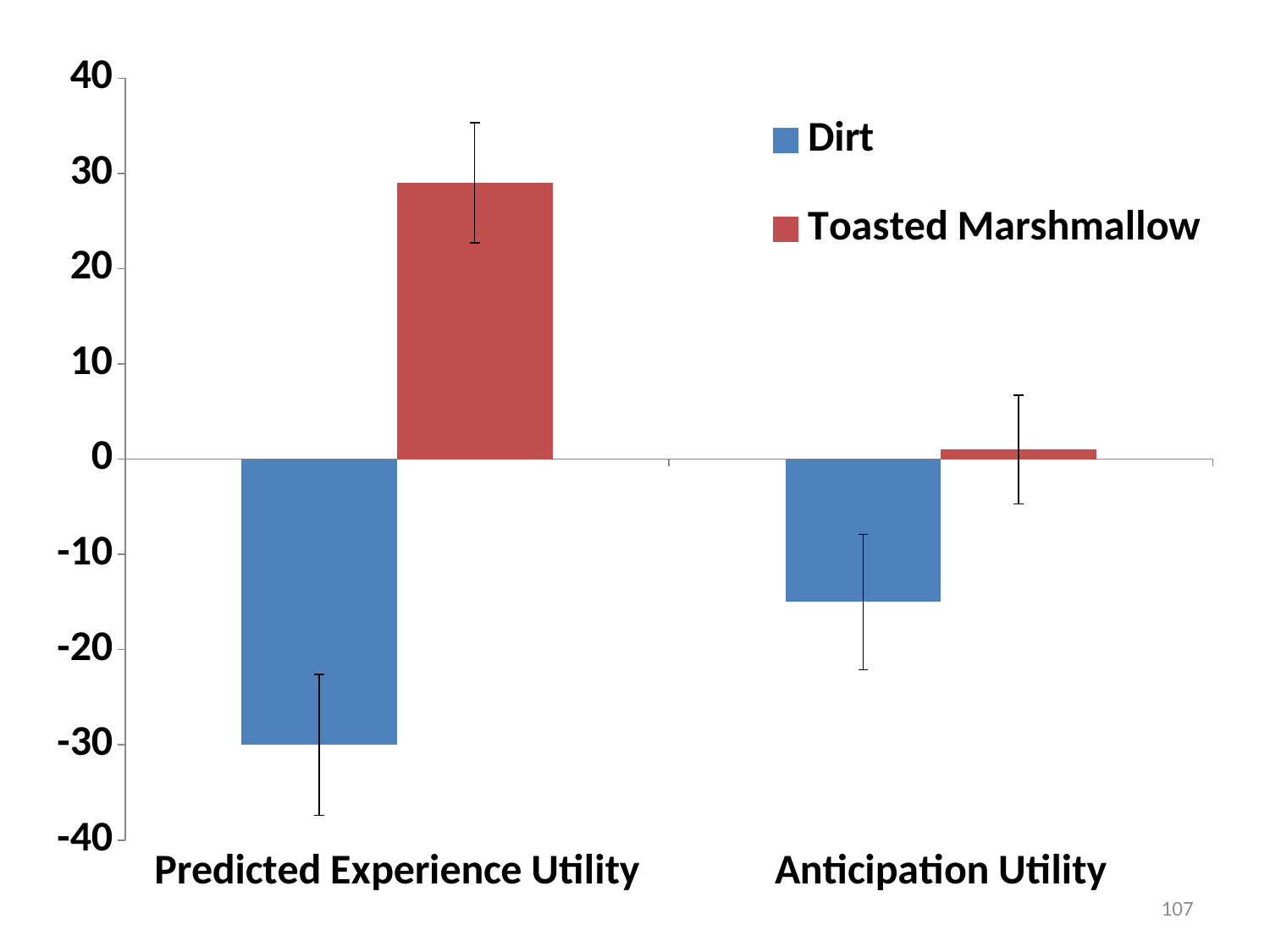
What kind of chart is shown on the slide? bar chart Is the value for Toasted Marshmallow under Predicted Experience Utility greater or less than 20? greater What colour represents the Dirt series? blue Which bar has the lowest value on the chart? Dirt, Predicted Experience Utility Which bar has the highest value on the chart? Toasted Marshmallow, Predicted Experience Utility Is the value for Toasted Marshmallow under Anticipation Utility greater or less than 10? less How many categories are shown on the x axis? 2 Is the value for Dirt under Anticipation Utility greater or less than -10? less For the Dirt series, which category has the larger value, Predicted Experience Utility or Anticipation Utility? Anticipation Utility Under Anticipation Utility, which series has the larger value, Dirt or Toasted Marshmallow? Toasted Marshmallow What are the two entries in the legend? Dirt and Toasted Marshmallow How many series does the legend list? 2